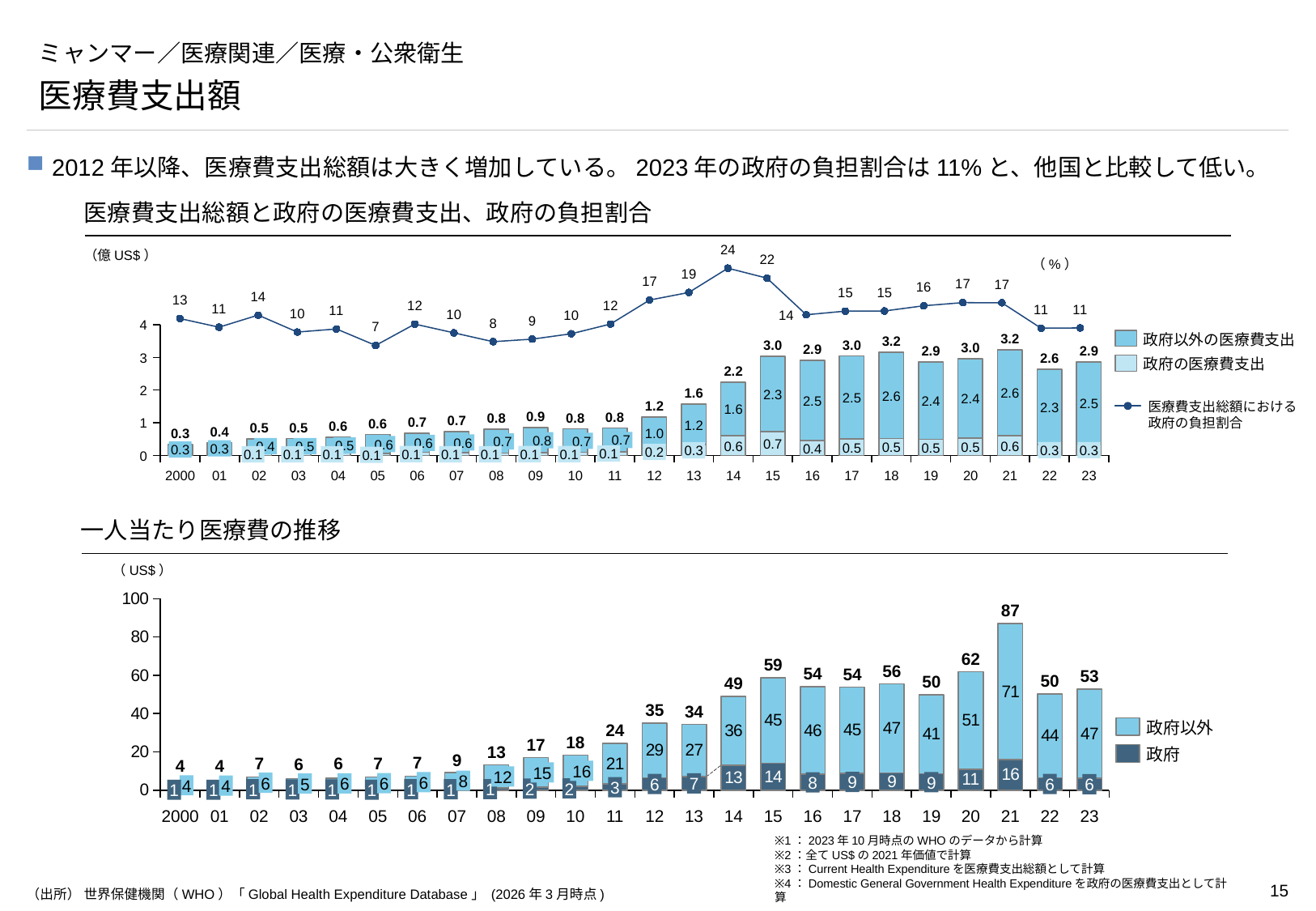
How many years are shown on the x axis of the top chart (医療費支出総額と政府の医療費支出、政府の負担割合)? 24 In the bottom chart (一人当たり医療費の推移), which year has the highest total per-capita health expenditure? 2021 In the bottom chart (一人当たり医療費の推移), what is the 政府 value for 2021? 16 In the bottom chart (一人当たり医療費の推移), what is the difference between the total for 2021 and the total for 2023? 34 In the top chart (医療費支出総額と政府の医療費支出、政府の負担割合), what is the 政府以外の医療費支出 value for 2018? 2.6 How many series does the legend of the bottom chart (一人当たり医療費の推移) list? 2 In the top chart (医療費支出総額と政府の医療費支出、政府の負担割合), in which year is the line 医療費支出総額における政府の負担割合 at its lowest? 2005 In the top chart (医療費支出総額と政府の医療費支出、政府の負担割合), what is the value of 医療費支出総額における政府の負担割合 for 2023? 11 In the bottom chart (一人当たり医療費の推移), what is the total per-capita health expenditure in 2021? 87 What kind of chart is the bottom chart titled 一人当たり医療費の推移? bar chart In the top chart (医療費支出総額と政府の医療費支出、政府の負担割合), which year has the larger total health expenditure, 2014 or 2015? 2015 In the top chart (医療費支出総額と政府の医療費支出、政府の負担割合), in which year does the line 医療費支出総額における政府の負担割合 reach its highest value? 2014